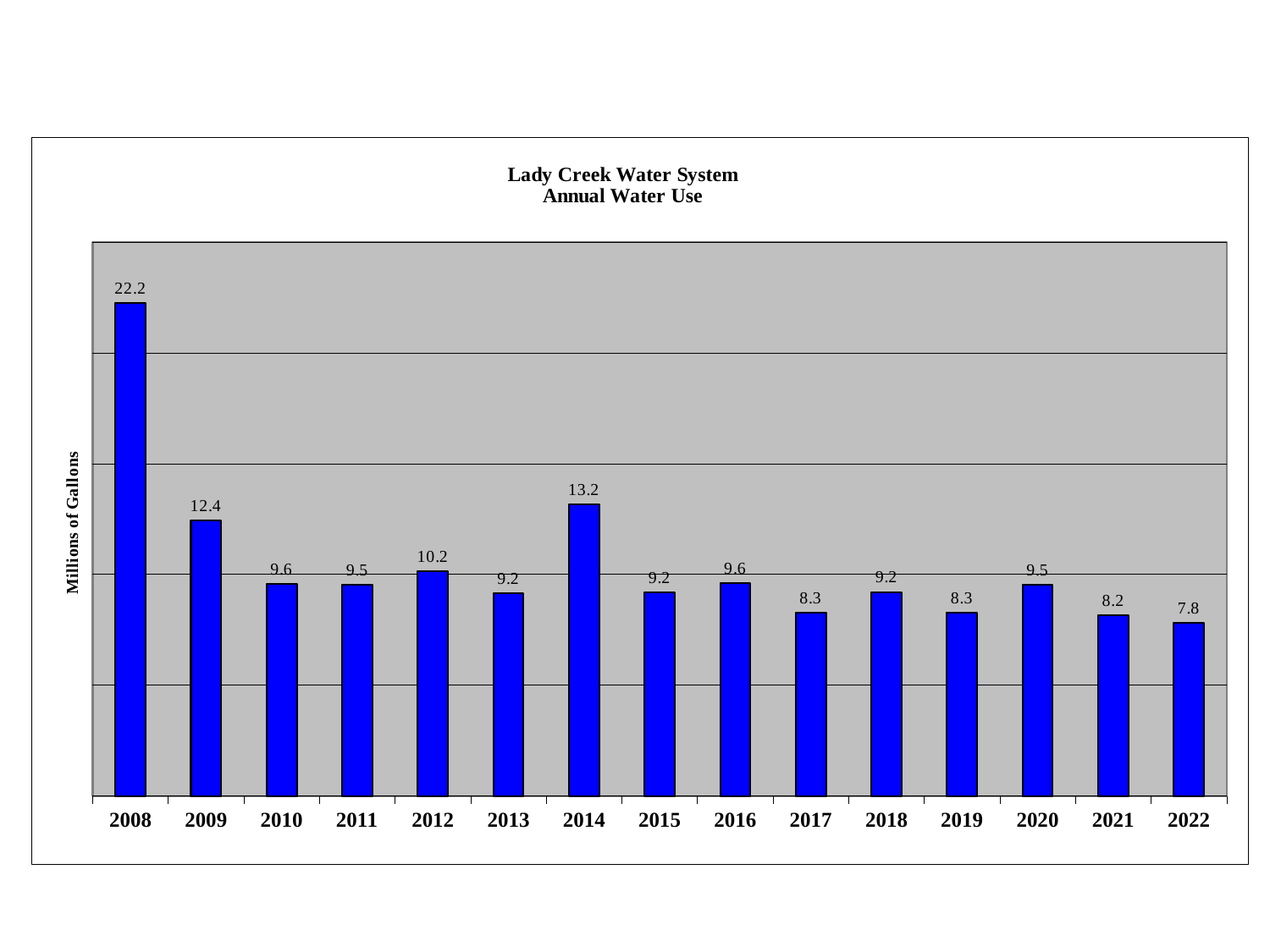
How many years are shown on the x axis? 15 What is the label on the vertical axis? Millions of Gallons What is the difference between the 2008 value and the 2009 value? 9.8 What is the title of the chart? Lady Creek Water System Annual Water Use What is the difference between the 2014 value and the 2013 value? 4.0 What is the annual water use value for 2022? 7.8 What kind of chart is this? bar chart Which is larger, the value for 2012 or the value for 2017? 2012 What is the annual water use value for 2014? 13.2 What is the annual water use value for 2008? 22.2 Which year has the lowest annual water use? 2022 Which year has the highest annual water use? 2008